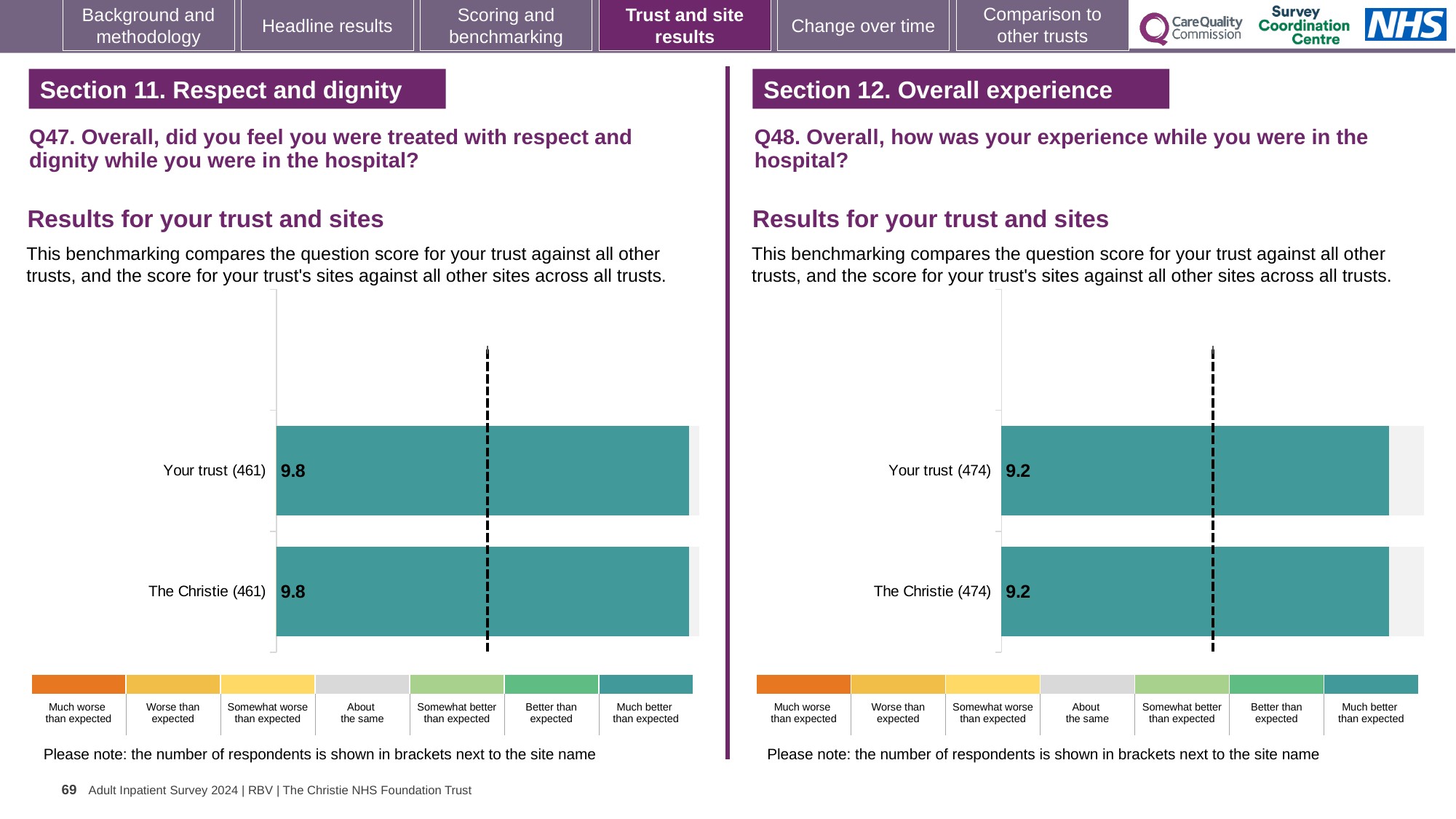
On the right chart (Q48, overall experience), what is the score for The Christie? 9.2 What kind of chart is used on the left (Q47) to show the results for your trust and sites? Bar chart On the left chart (Q47), what is the difference between the score for Your trust and the score for The Christie? 0 On the left chart (Q47), how many respondents are shown in brackets next to The Christie? 461 Is the score for Your trust on the left chart (Q47) larger than the score for Your trust on the right chart (Q48)? Yes On the left chart (Q47, respect and dignity), what is the score for Your trust? 9.8 On the left chart (Q47), how many bars are plotted? 2 On the right chart (Q48), how many bars are plotted? 2 On the right chart (Q48), which category does the colour of the bars correspond to in the key below the chart? Much better than expected On the right chart (Q48, overall experience), what is the score for Your trust? 9.2 On the right chart (Q48), how many respondents are shown in brackets next to Your trust? 474 On the left chart (Q47, respect and dignity), what is the score for The Christie? 9.8